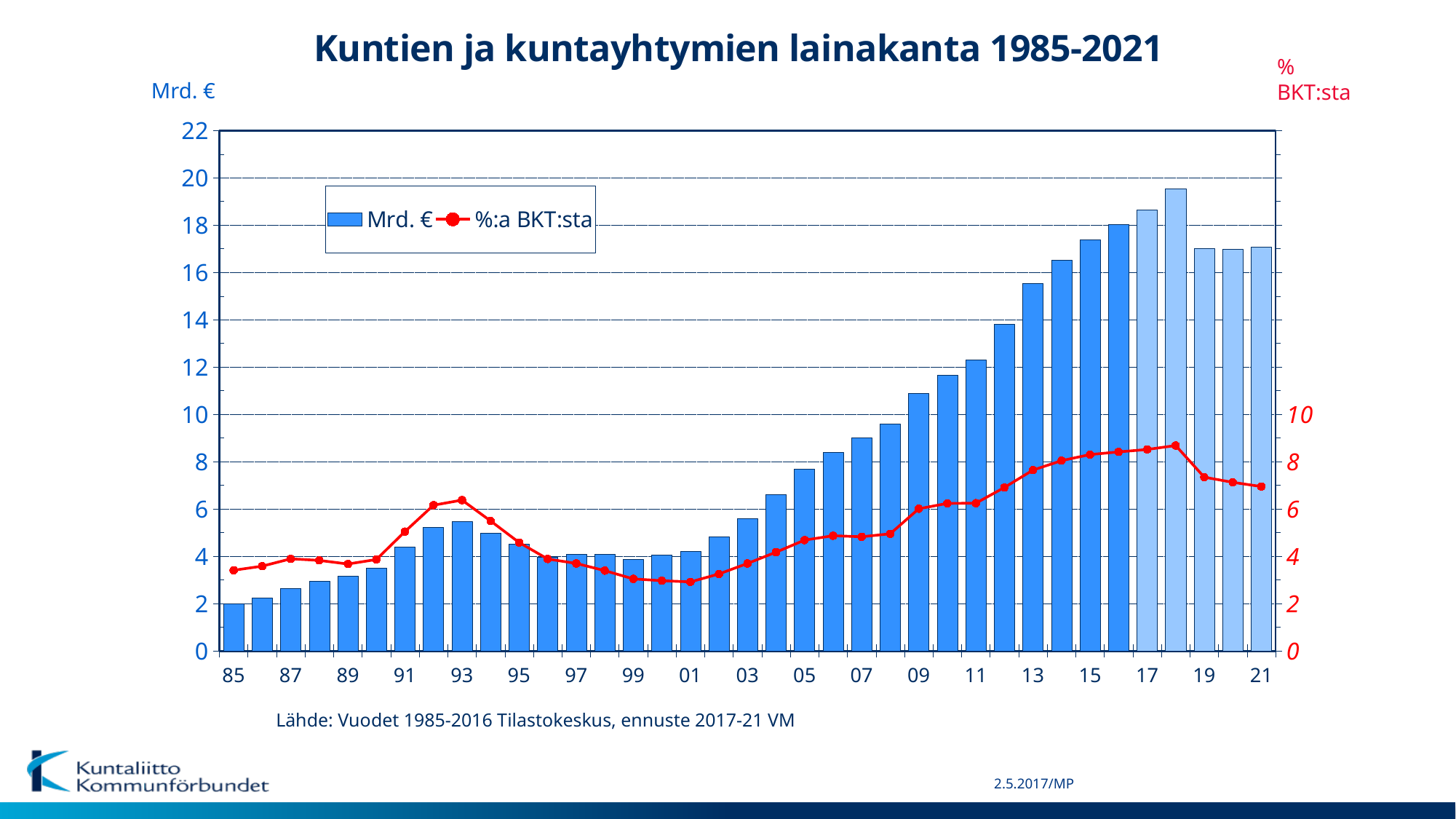
Is the %:a BKT:sta value for 2001 greater or less than 4? less Is the Mrd. € value for 1985 greater or less than 4? less How many series does the legend list? 2 Is the Mrd. € value for 2013 greater or less than 14? greater Which year has the highest bar for Mrd. €? 2018 (18) What is the title of the chart? Kuntien ja kuntayhtymien lainakanta 1985-2021 What kind of chart is shown on the slide? A combined bar and line chart Which is larger, the Mrd. € bar for 2012 or for 2005? 2012 How many years (bars) are plotted in the chart? 37 Do the Mrd. € bars rise or fall from 2001 to 2018? rise Which year has the lowest bar for Mrd. €? 1985 (85)